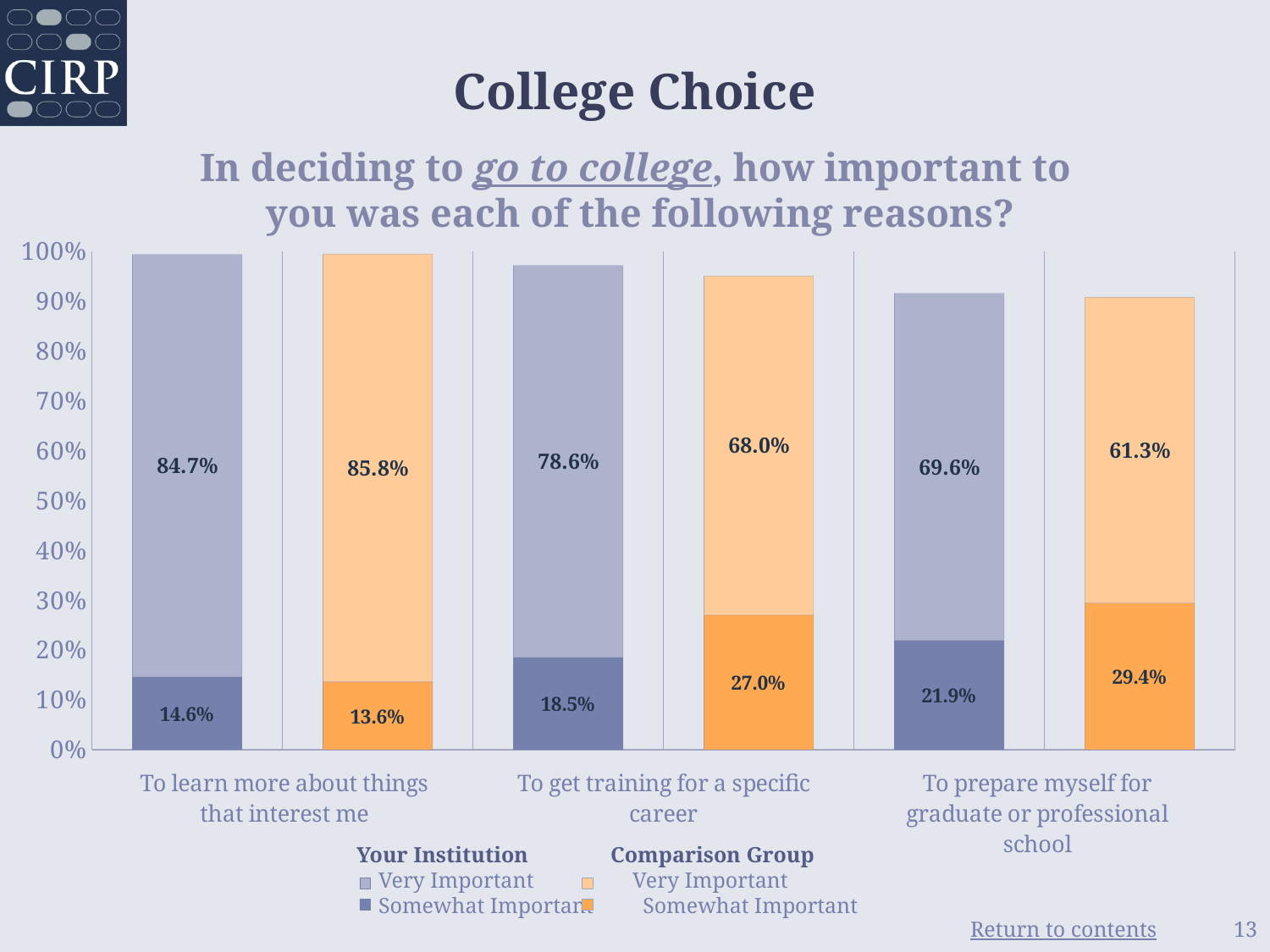
Which reason has the lowest Very Important percentage for Your Institution? To prepare myself for graduate or professional school What is the combined Very Important and Somewhat Important percentage for Your Institution for "To get training for a specific career"? 97.1% What percentage of the Comparison Group rated "To get training for a specific career" as Somewhat Important? 27.0% What percentage of Your Institution students rated "To learn more about things that interest me" as Very Important? 84.7% What type of chart is shown on the slide? Stacked bar chart How many reasons (categories) are shown on the x axis of the chart? 3 How many series does the chart legend list? 4 For "To prepare myself for graduate or professional school", which group has the larger Somewhat Important percentage, Your Institution or the Comparison Group? Comparison Group What is the combined Very Important and Somewhat Important percentage for the Comparison Group for "To prepare myself for graduate or professional school"? 90.7% What is the difference between the Your Institution and Comparison Group Very Important percentages for "To get training for a specific career"? 10.6% What percentage of Your Institution students rated "To prepare myself for graduate or professional school" as Somewhat Important? 21.9% Which reason has the highest Very Important percentage for the Comparison Group? To learn more about things that interest me